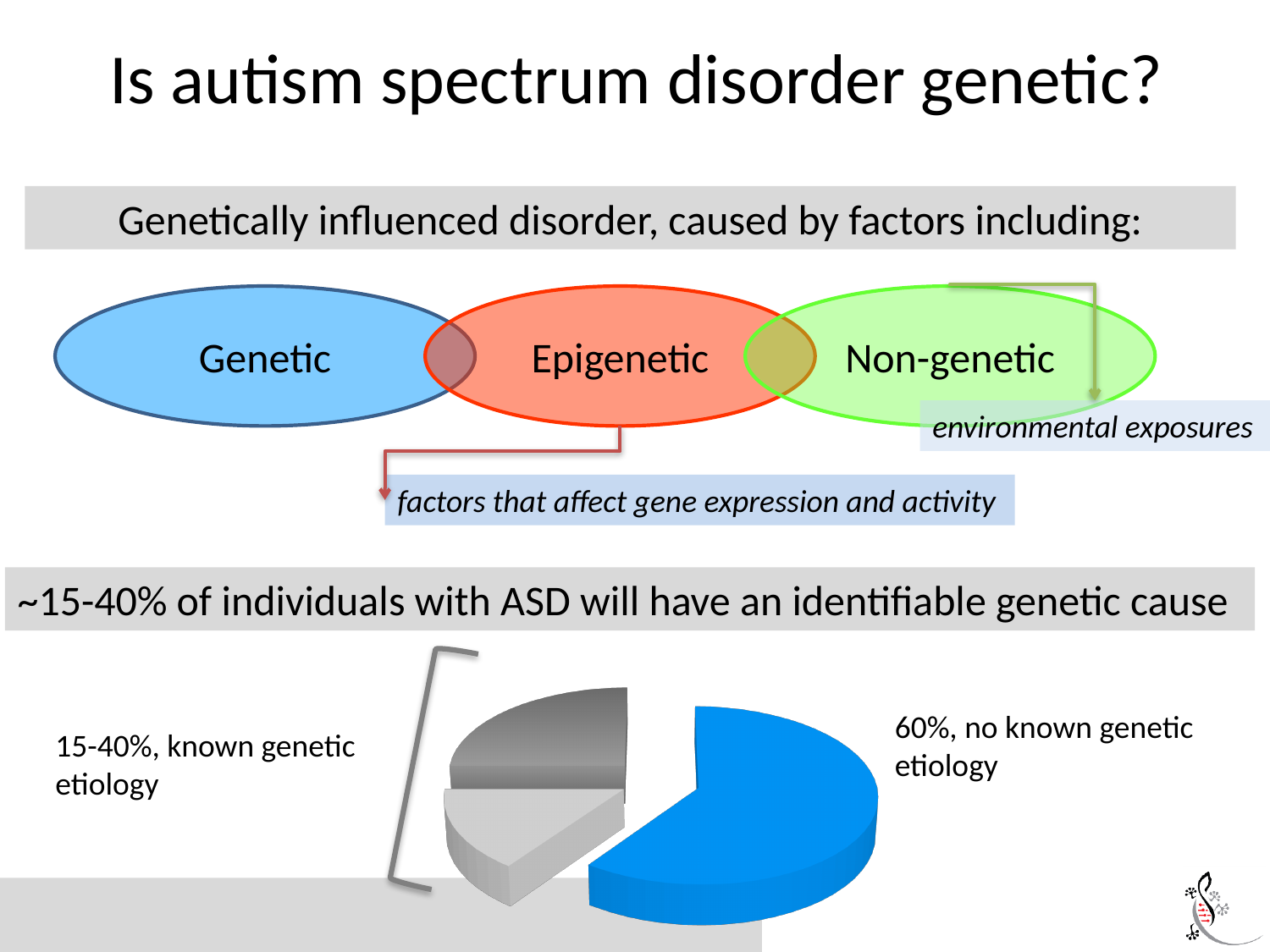
Which category does the smallest slice of the pie chart belong to? known genetic etiology Is the share for no known genetic etiology in the pie chart greater or less than 50%? greater What colour is the slice representing no known genetic etiology in the pie chart? blue What colour are the slices representing known genetic etiology in the pie chart? gray Which is larger in the pie chart: the slice for no known genetic etiology or the slices for known genetic etiology? no known genetic etiology In the pie chart, what share of individuals with ASD have a known genetic etiology? 15-40% In the pie chart, what share of individuals with ASD have no known genetic etiology? 60% Which category does the largest slice of the pie chart represent? no known genetic etiology What kind of chart is shown at the bottom of the slide? pie chart How many slices does the pie chart have? 3